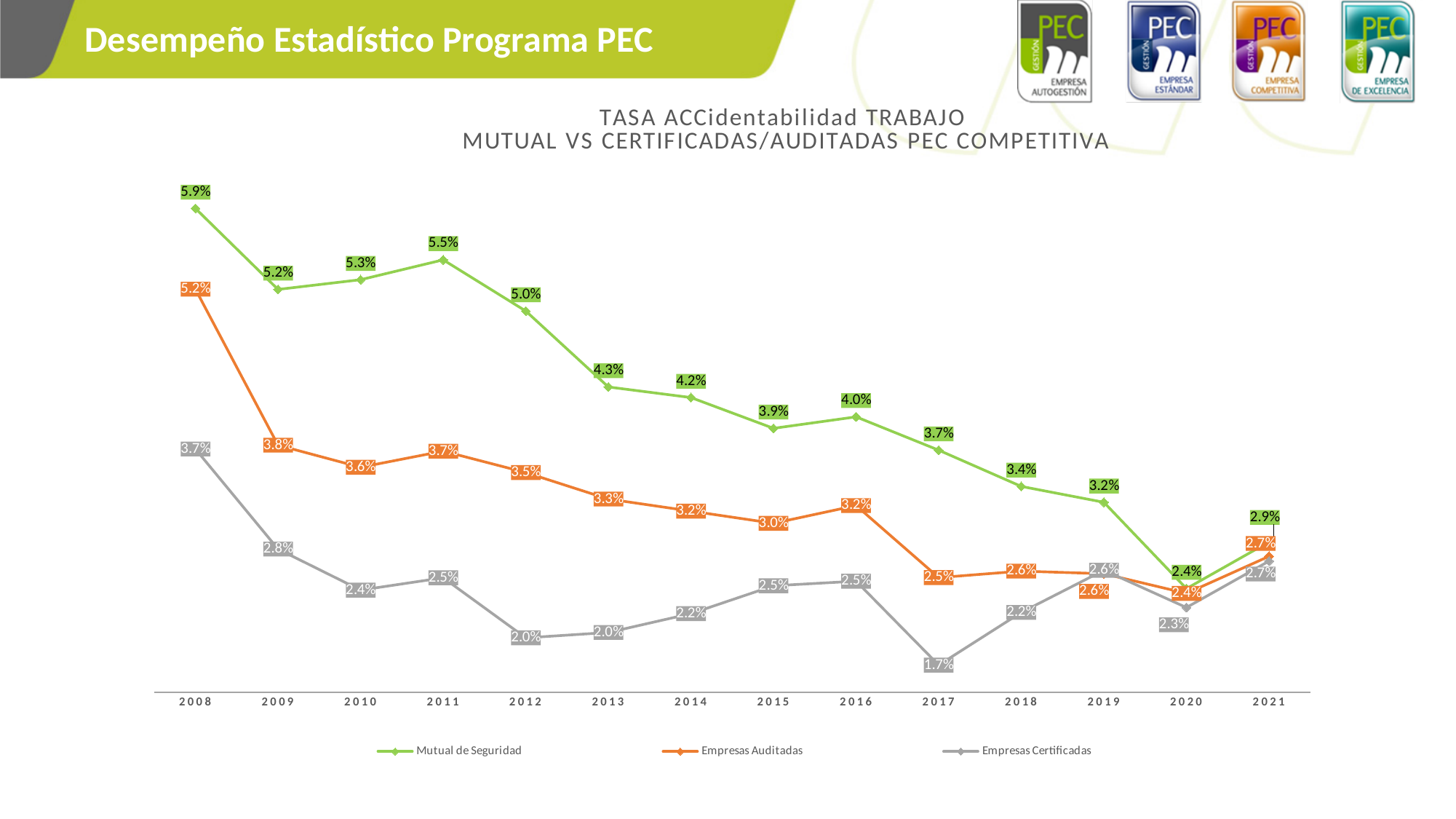
What is the value for Empresas Auditadas in 2013? 3.3% In which year does Empresas Certificadas reach its highest value? 2008 How many years are shown on the x axis? 14 What is the difference between Mutual de Seguridad and Empresas Auditadas in 2012? 1.5% In which year does Mutual de Seguridad reach its lowest value? 2020 Which series is drawn in orange? Empresas Auditadas How many series does the legend list? 3 What is the value for Mutual de Seguridad in 2008? 5.9% Does the Mutual de Seguridad series generally rise or fall from 2008 to 2020? fall What is the value for Empresas Certificadas in 2017? 1.7% What type of chart is shown on the slide? line chart Which series has the larger value in 2016, Mutual de Seguridad or Empresas Certificadas? Mutual de Seguridad